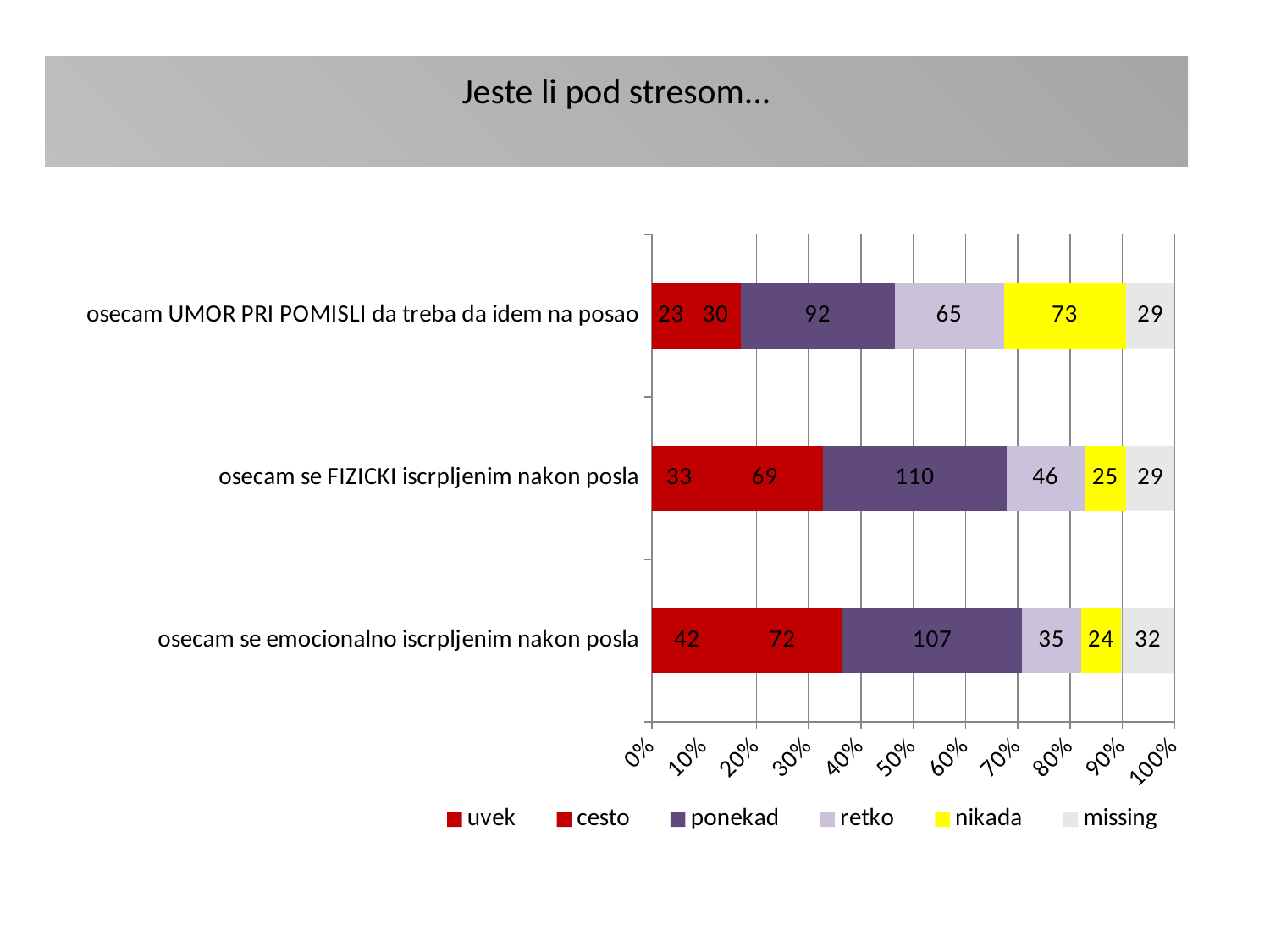
How many series does the legend list? 6 Which statement has the highest 'uvek' value? osecam se emocionalno iscrpljenim nakon posla What is the difference between the 'retko' values for 'osecam UMOR PRI POMISLI da treba da idem na posao' and 'osecam se emocionalno iscrpljenim nakon posla'? 30 What is the value of 'missing' for 'osecam se emocionalno iscrpljenim nakon posla'? 32 What is the value of 'nikada' for 'osecam UMOR PRI POMISLI da treba da idem na posao'? 73 How many categories (statements) are plotted on the chart? 3 What is the value of 'ponekad' for 'osecam se FIZICKI iscrpljenim nakon posla'? 110 Which statement has the lowest 'nikada' value? osecam se emocionalno iscrpljenim nakon posla Which is larger: the 'cesto' value for 'osecam se FIZICKI iscrpljenim nakon posla' or for 'osecam se emocionalno iscrpljenim nakon posla'? osecam se emocionalno iscrpljenim nakon posla What kind of chart is shown on the slide? stacked bar chart What is the total of all segments in the bar for 'osecam se FIZICKI iscrpljenim nakon posla'? 312 What is the value of 'uvek' for 'osecam se emocionalno iscrpljenim nakon posla'? 42